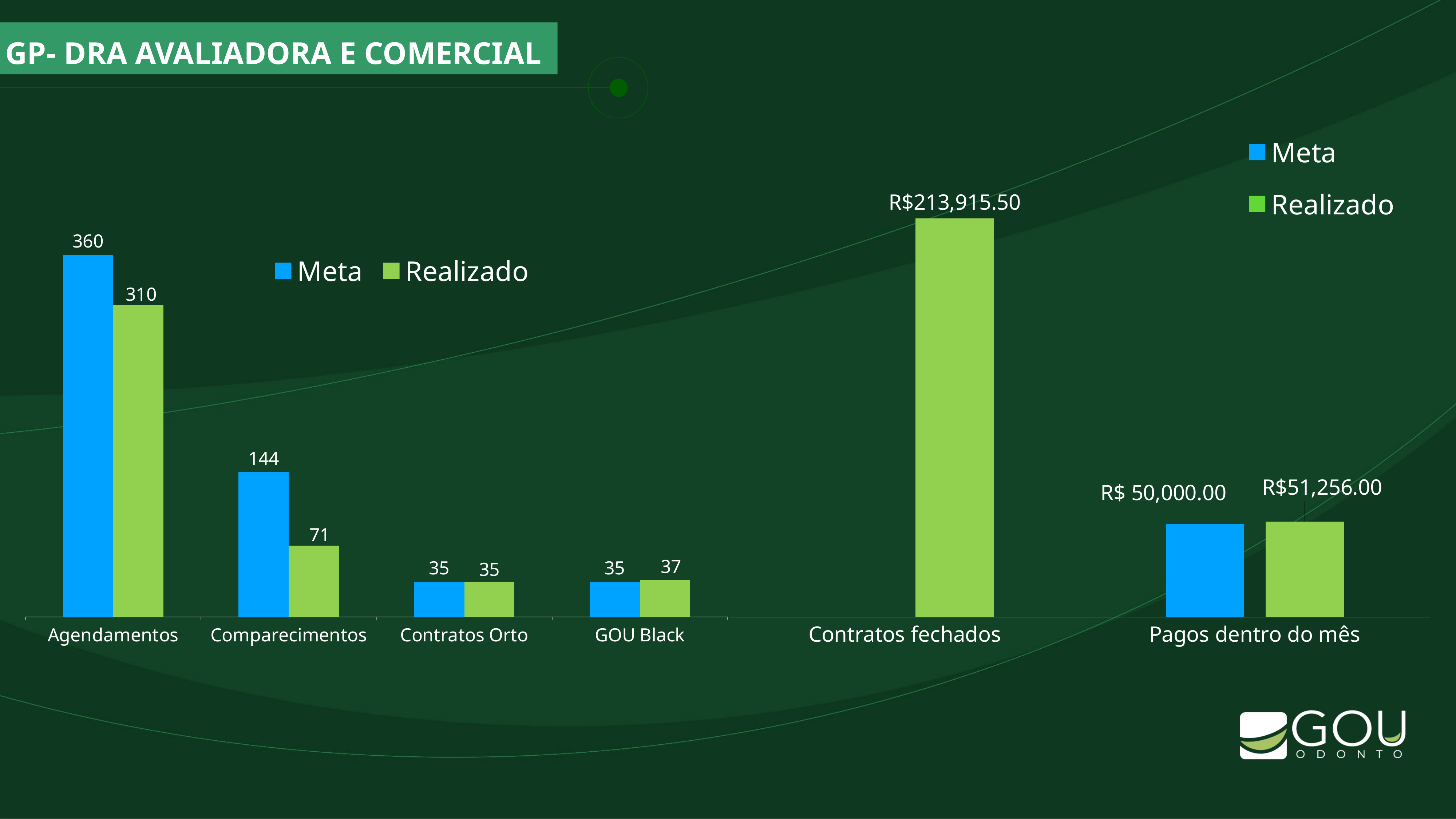
In the left chart, how many series does the legend list? 2 In the right chart, what is the Meta value for Pagos dentro do mês? R$ 50,000.00 In the left chart, what is the Realizado value for GOU Black? 37 In the left chart, what is the difference between the Meta and Realizado values for Comparecimentos? 73 In the left chart, what is the Meta value for Agendamentos? 360 In the left chart, which category has the highest Meta value? Agendamentos In the left chart, what is the difference between the Meta and Realizado values for Agendamentos? 50 In the left chart, what is the Realizado value for Comparecimentos? 71 In the right chart, what is the Realizado value for Contratos fechados? R$213,915.50 In the left chart, is the Realizado value for Agendamentos larger or smaller than the Meta value? smaller What type of chart is the right chart? bar chart In the left chart, how many categories are shown on the x axis? 4